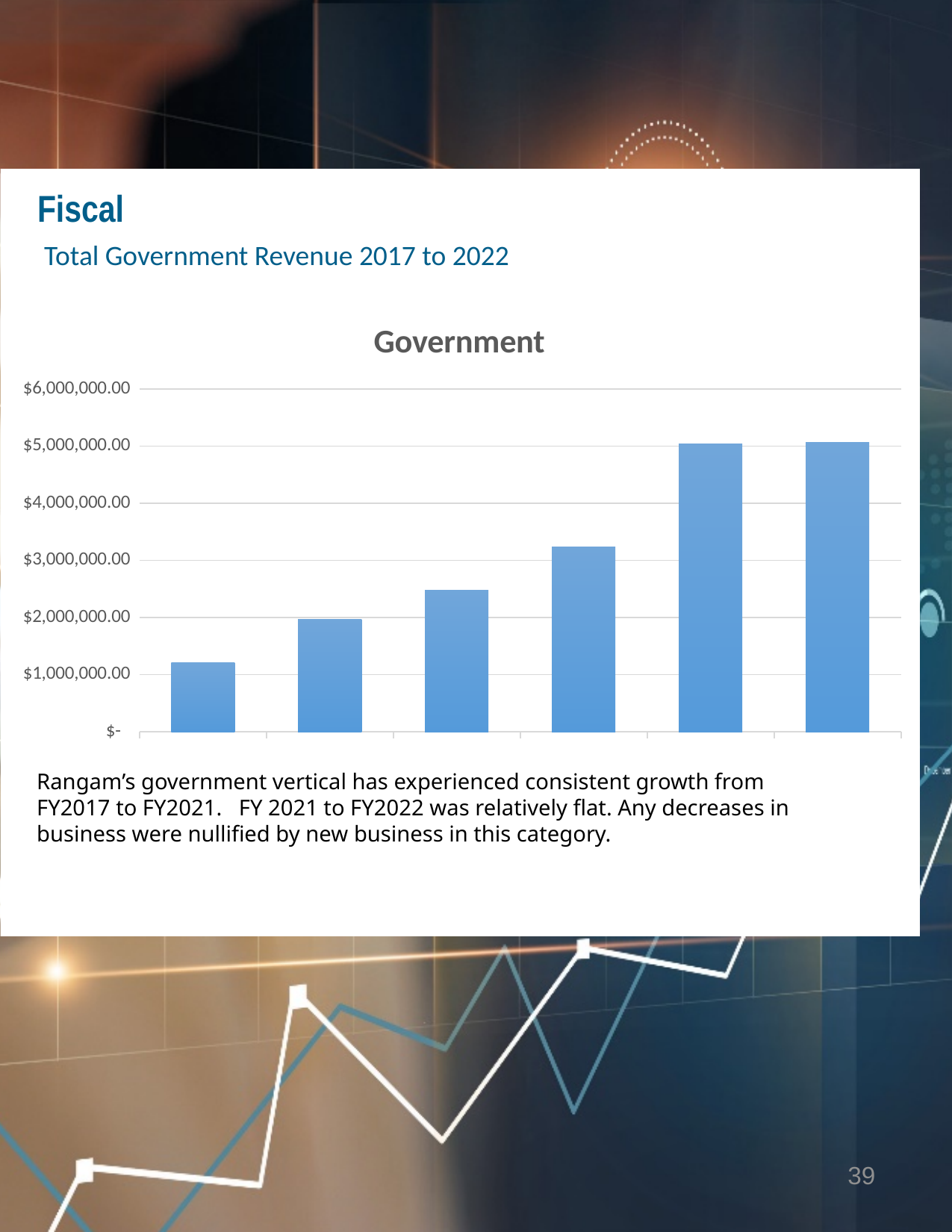
Is the value of the fourth bar greater or less than $3,000,000.00? greater Which bar is the lowest in the chart? the first (leftmost) bar What is the title of the chart? Government Is the value of the third bar greater or less than $2,000,000.00? greater What is the highest value shown on the vertical axis? $6,000,000.00 How many bars are plotted in the Government chart? 6 Is the value of the first (leftmost) bar greater or less than $2,000,000.00? less Do the bar values generally rise or fall from left to right across the chart? rise What kind of chart is shown on the slide? bar chart Which is larger, the third bar or the fourth bar? the fourth bar